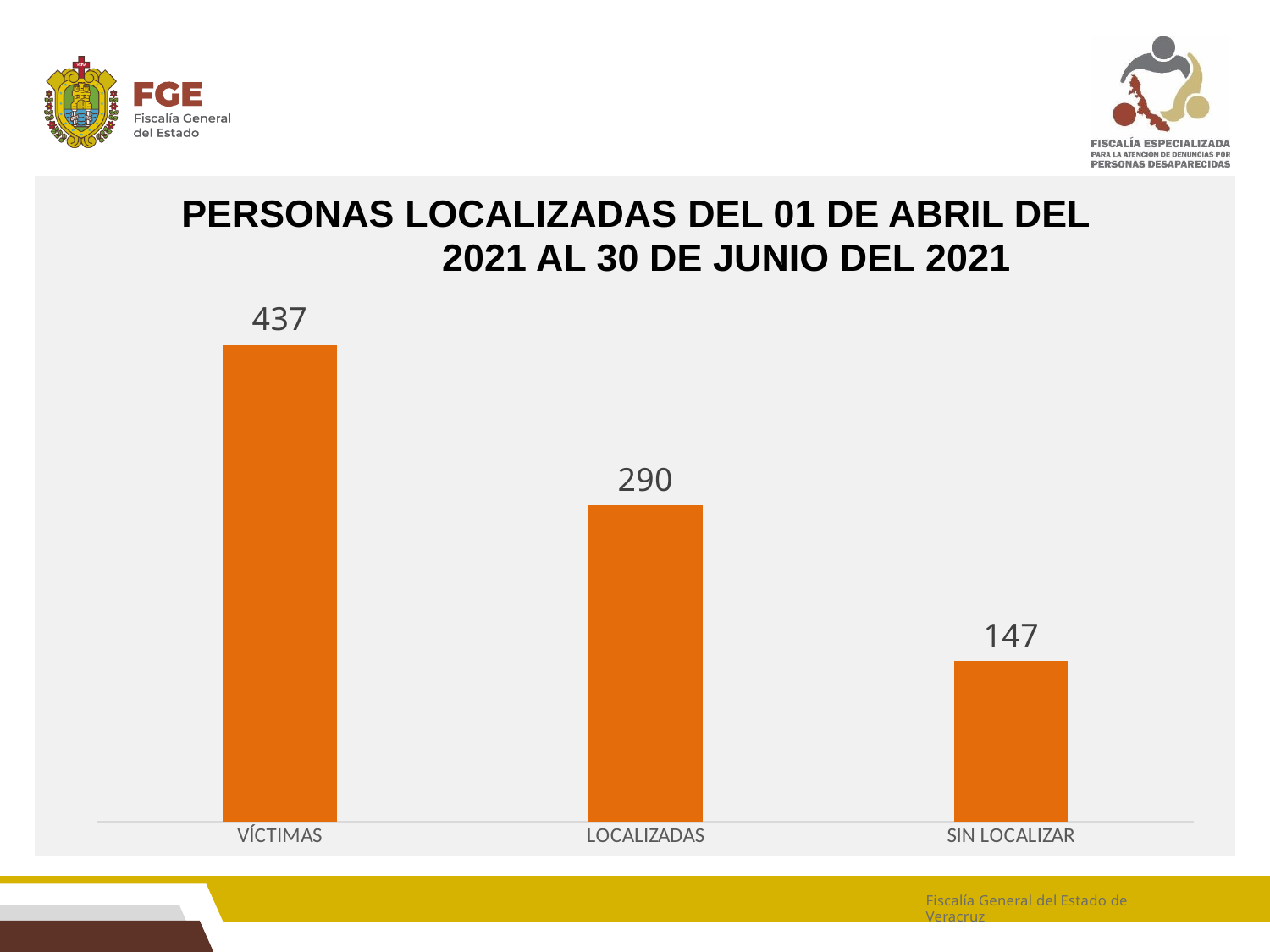
What is the value for VÍCTIMAS? 437 What is the difference between the values for LOCALIZADAS and SIN LOCALIZAR? 143 What is the value for LOCALIZADAS? 290 What kind of chart is shown on the slide? Bar chart What is the title of the chart? PERSONAS LOCALIZADAS DEL 01 DE ABRIL DEL 2021 AL 30 DE JUNIO DEL 2021 Which is larger, the value for LOCALIZADAS or the value for SIN LOCALIZAR? LOCALIZADAS Do the values rise or fall from left to right across the categories? Fall Which category has the highest value? VÍCTIMAS Which category has the lowest value? SIN LOCALIZAR What is the value for SIN LOCALIZAR? 147 What is the difference between the values for VÍCTIMAS and LOCALIZADAS? 147 How many categories are shown in the chart? 3